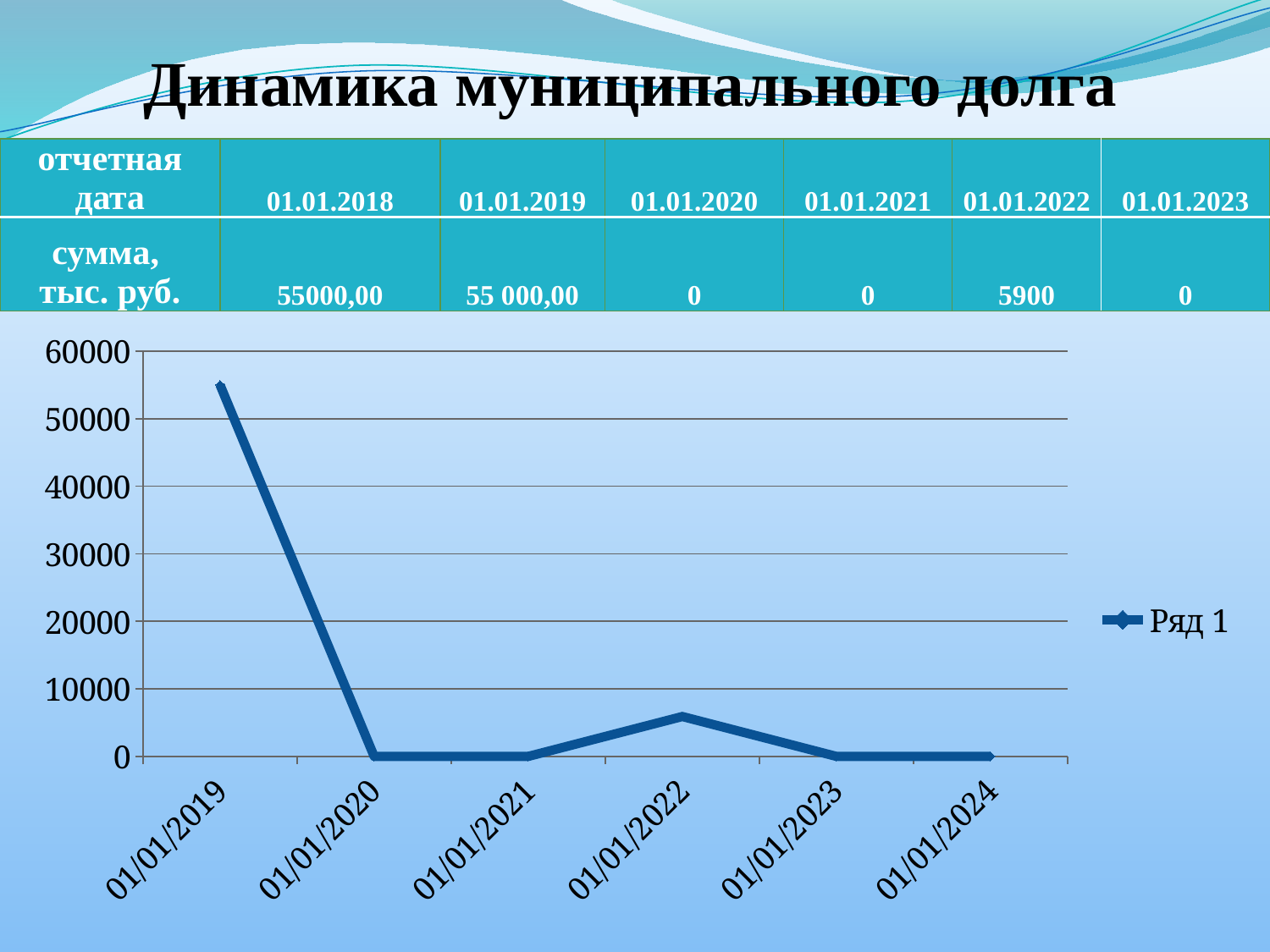
Is the value for 01/01/2022 greater or less than 10000? less What is the value plotted for 01/01/2020? 0 What is the name of the series shown in the chart legend? Ряд 1 Is the value for 01/01/2019 greater or less than 50000? greater Which has the larger value, 01/01/2019 or 01/01/2022? 01/01/2019 How many series does the chart legend list? 1 Does the line rise or fall between 01/01/2019 and 01/01/2020? fall Which has the larger value, 01/01/2022 or 01/01/2023? 01/01/2022 What kind of chart is shown on the slide? line chart What is the title of the slide containing the chart? Динамика муниципального долга How many data points are plotted on the line chart? 6 Which date has the highest value on the line chart? 01/01/2019